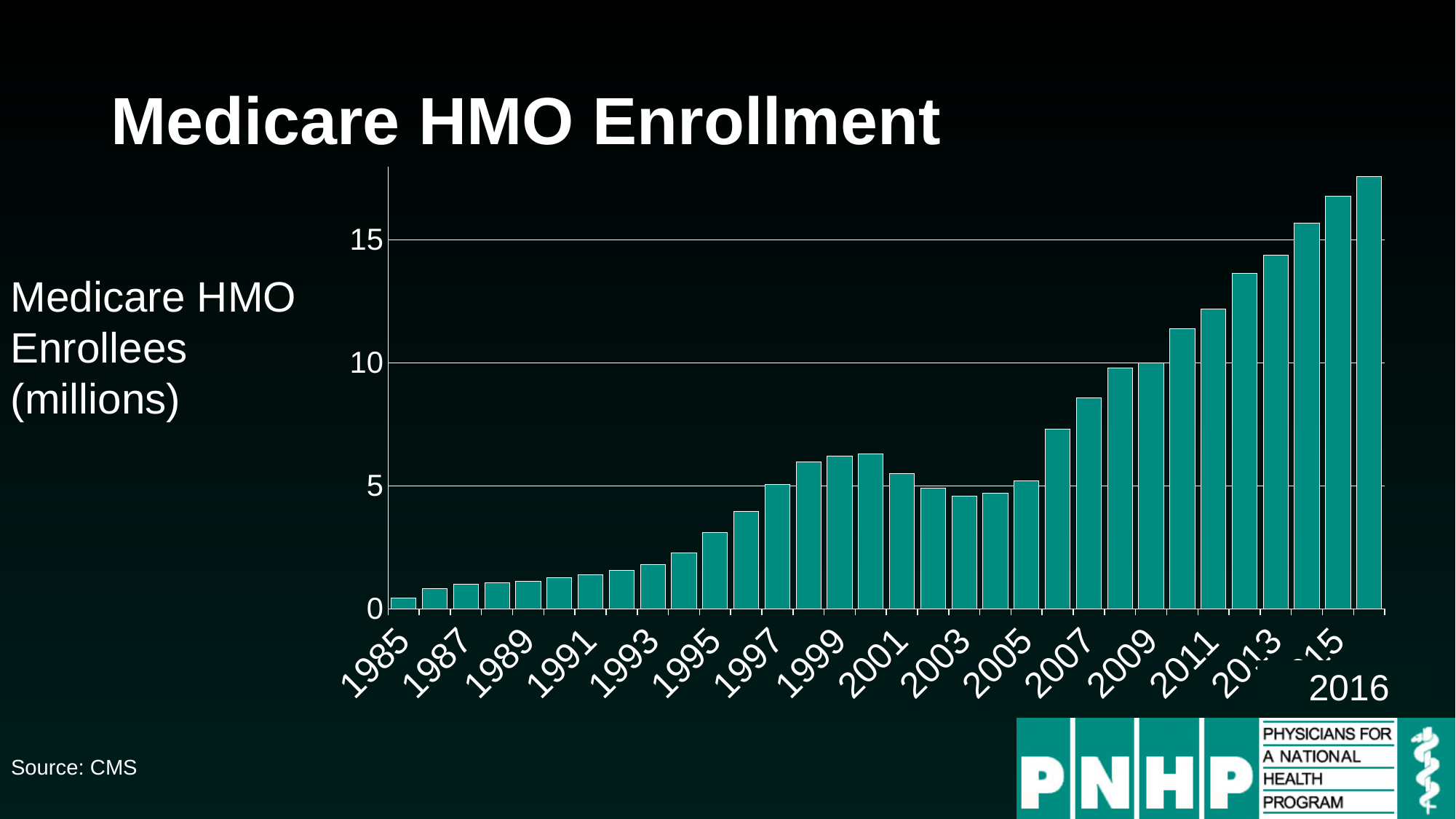
What kind of chart is shown on the slide? Bar chart What is the title of the chart? Medicare HMO Enrollment Which year has the highest Medicare HMO enrollment? 2016 Is the value for 2003 greater or less than 5? less Which year has the larger Medicare HMO enrollment, 2000 or 2005? 2000 Overall, do Medicare HMO enrollment values rise or fall from 1985 to 2016? Rise How many years (bars) are plotted on the chart? 32 Is the value for 2011 greater or less than 10? greater In what units are Medicare HMO enrollees plotted on the chart? Millions Which year has the lowest Medicare HMO enrollment? 1985 Is the value for 2016 greater or less than 15? greater